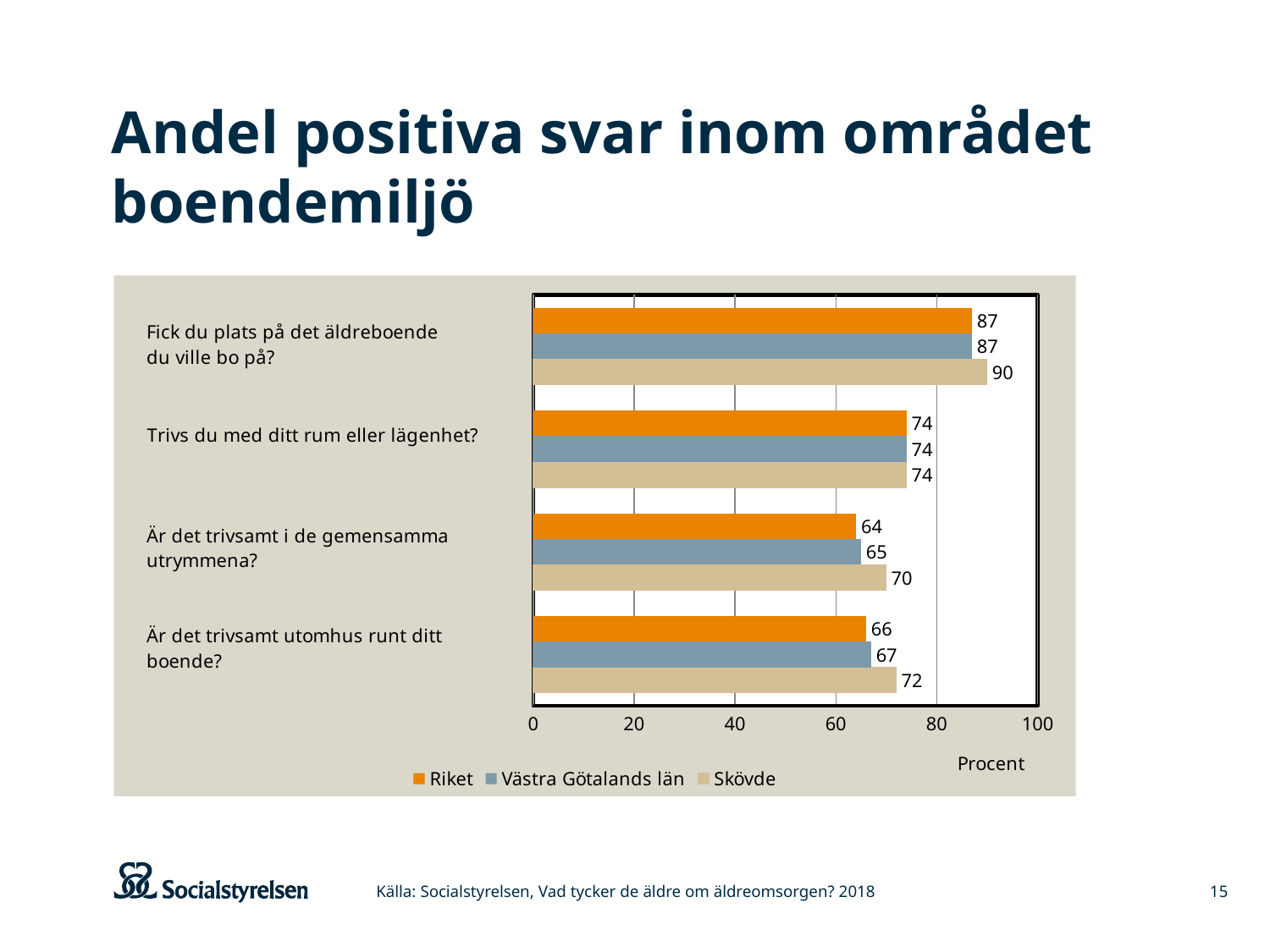
What kind of chart is shown on the slide? bar chart What is the value for Skövde on "Fick du plats på det äldreboende du ville bo på?"? 90 Is the value for Riket on "Trivs du med ditt rum eller lägenhet?" greater or less than 60? greater How many questions (categories) are shown on the chart? 4 How many series does the legend list? 3 What unit is shown on the x axis label? Procent What is the value for Riket on "Är det trivsamt i de gemensamma utrymmena?"? 64 Which is larger on "Är det trivsamt i de gemensamma utrymmena?": Skövde or Västra Götalands län? Skövde Which question has the lowest value for Riket? Är det trivsamt i de gemensamma utrymmena? What is the difference between Skövde and Riket on "Är det trivsamt utomhus runt ditt boende?"? 6 Which question has the highest value for Skövde? Fick du plats på det äldreboende du ville bo på? What is the value for Västra Götalands län on "Är det trivsamt utomhus runt ditt boende?"? 67